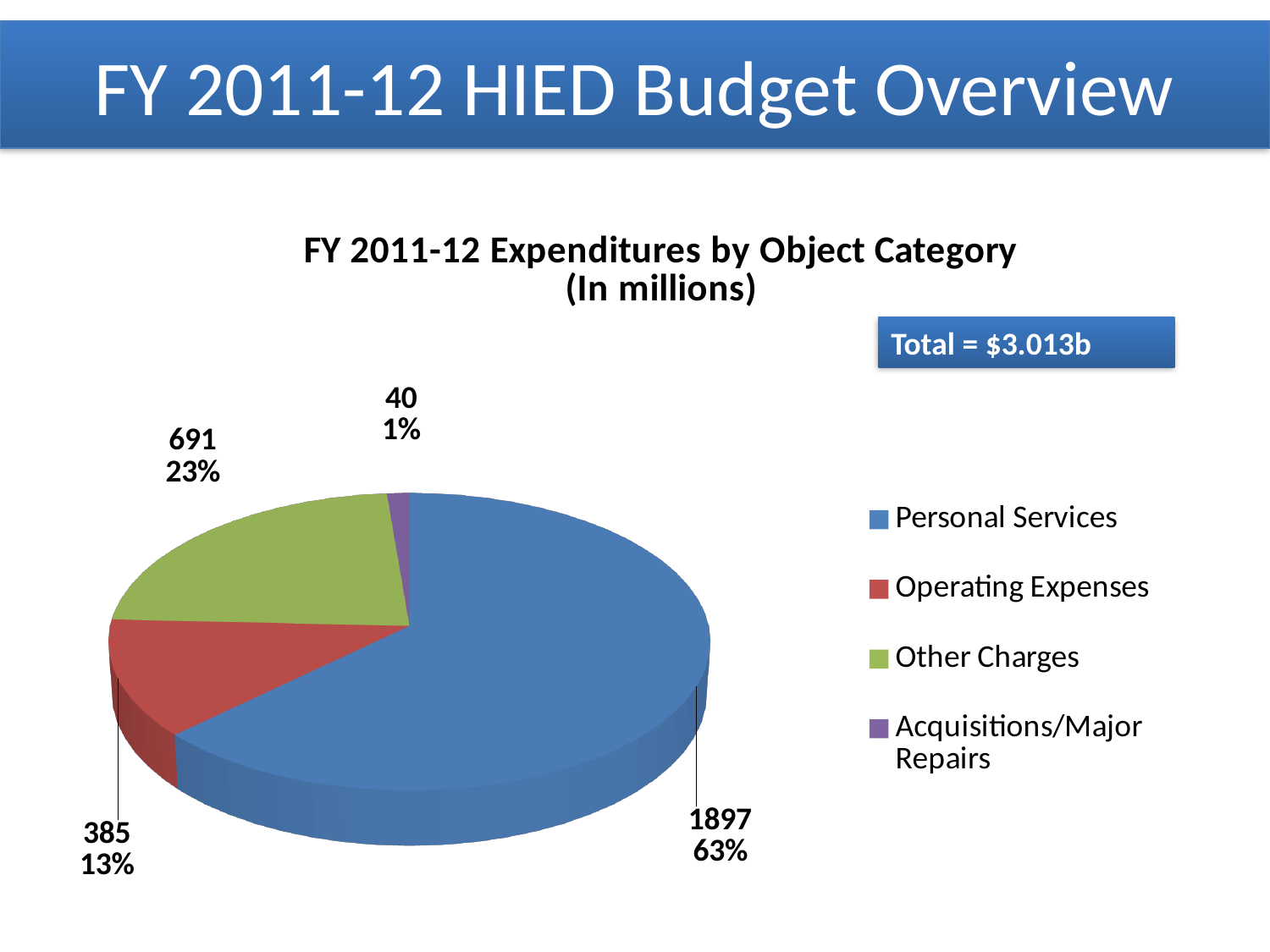
What is the value for Acquisitions/Major Repairs? 40 What type of chart is shown on the slide? Pie chart What is the value for Personal Services? 1897 What percentage share of the pie is Operating Expenses? 13% What is the difference between the values for Personal Services and Other Charges? 1206 Which is larger, the value for Other Charges or the value for Operating Expenses? Other Charges What is the value for Other Charges? 691 Which category has the smallest share of the pie? Acquisitions/Major Repairs Which category has the largest share of the pie? Personal Services What is the value for Operating Expenses? 385 What percentage share of the pie is Other Charges? 23% How many categories does the legend list? 4